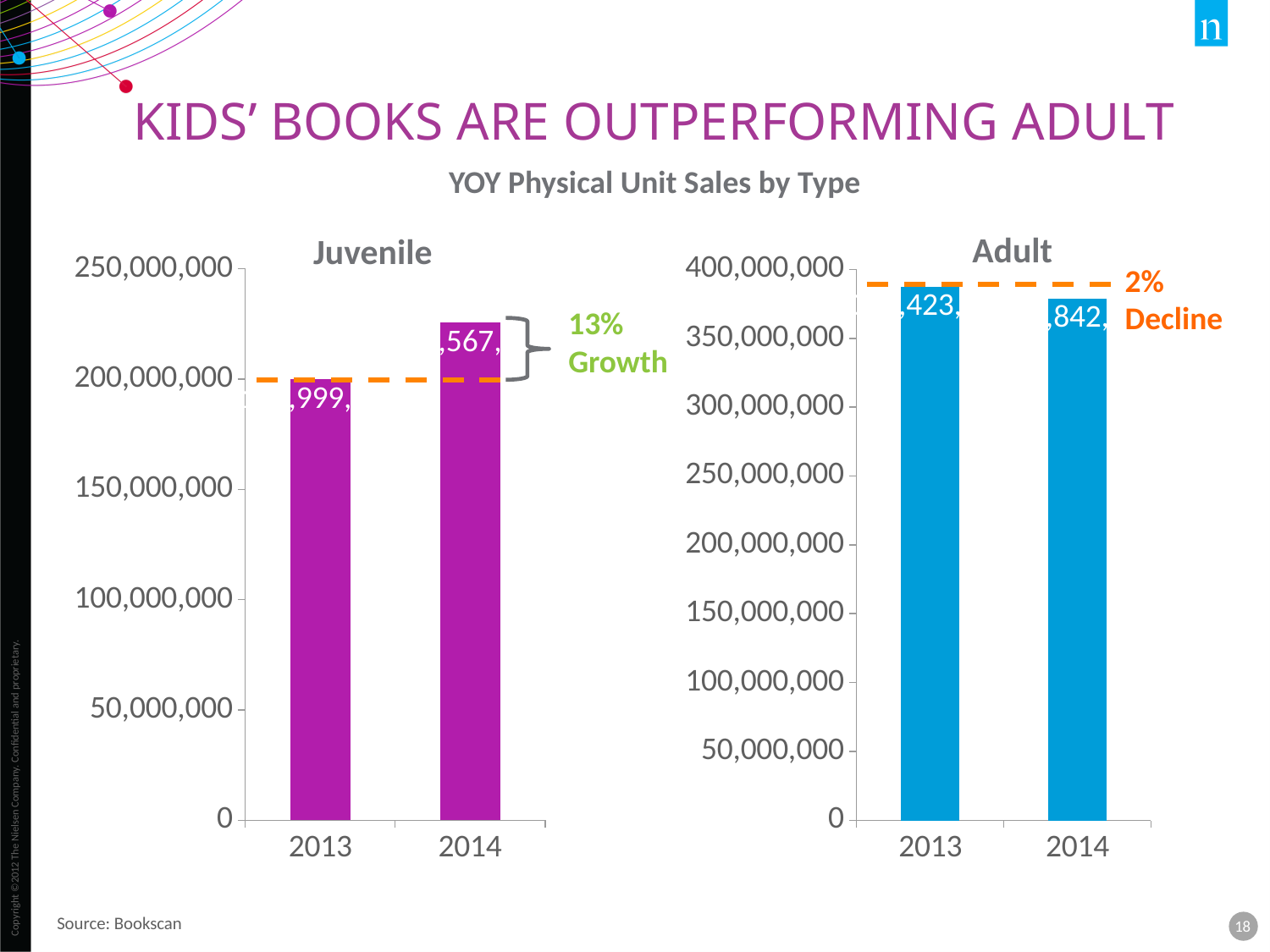
In the Juvenile chart, is the value for 2014 greater or less than 200,000,000? greater In the Adult chart, is the value for 2014 greater or less than 400,000,000? less What percentage change is annotated on the Adult chart? 2% Decline What percentage growth is annotated on the Juvenile chart? 13% Growth In the Juvenile chart, which year has the higher value? 2014 In the Adult chart, do the values rise or fall from 2013 to 2014? fall In the Juvenile chart, do the values rise or fall from 2013 to 2014? rise In the Juvenile chart, which year has the lower value? 2013 What kind of chart is the Juvenile chart? bar chart How many categories are shown on the x axis of the Adult chart? 2 In the Juvenile chart, is the value for 2013 greater or less than 150,000,000? greater